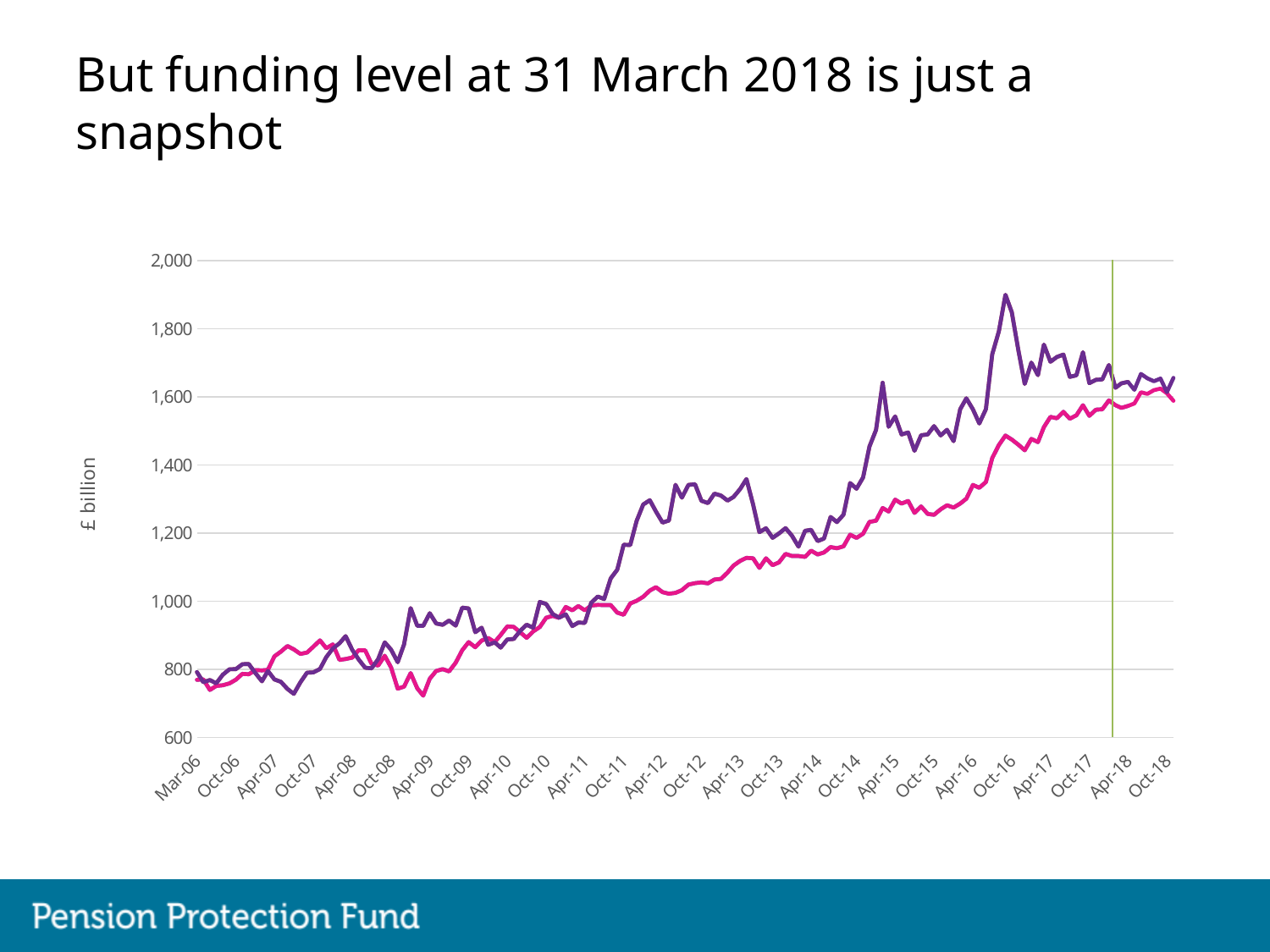
Is the value of the purple line at Apr-12 greater or less than 1,200? greater Do the plotted values generally rise or fall from Mar-06 to Oct-18? rise Which line reaches the highest value on the chart? purple line Is the peak of the purple line near Oct-16 greater or less than 1,800? greater Is the value of the pink line at Oct-18 greater or less than 1,400? greater What kind of chart is shown on the slide? line chart What is the label on the vertical axis of the chart? £ billion What is the highest value shown on the vertical axis? 2,000 At Apr-12, which line is higher, the purple line or the pink line? purple line How many lines are plotted on the chart? 2